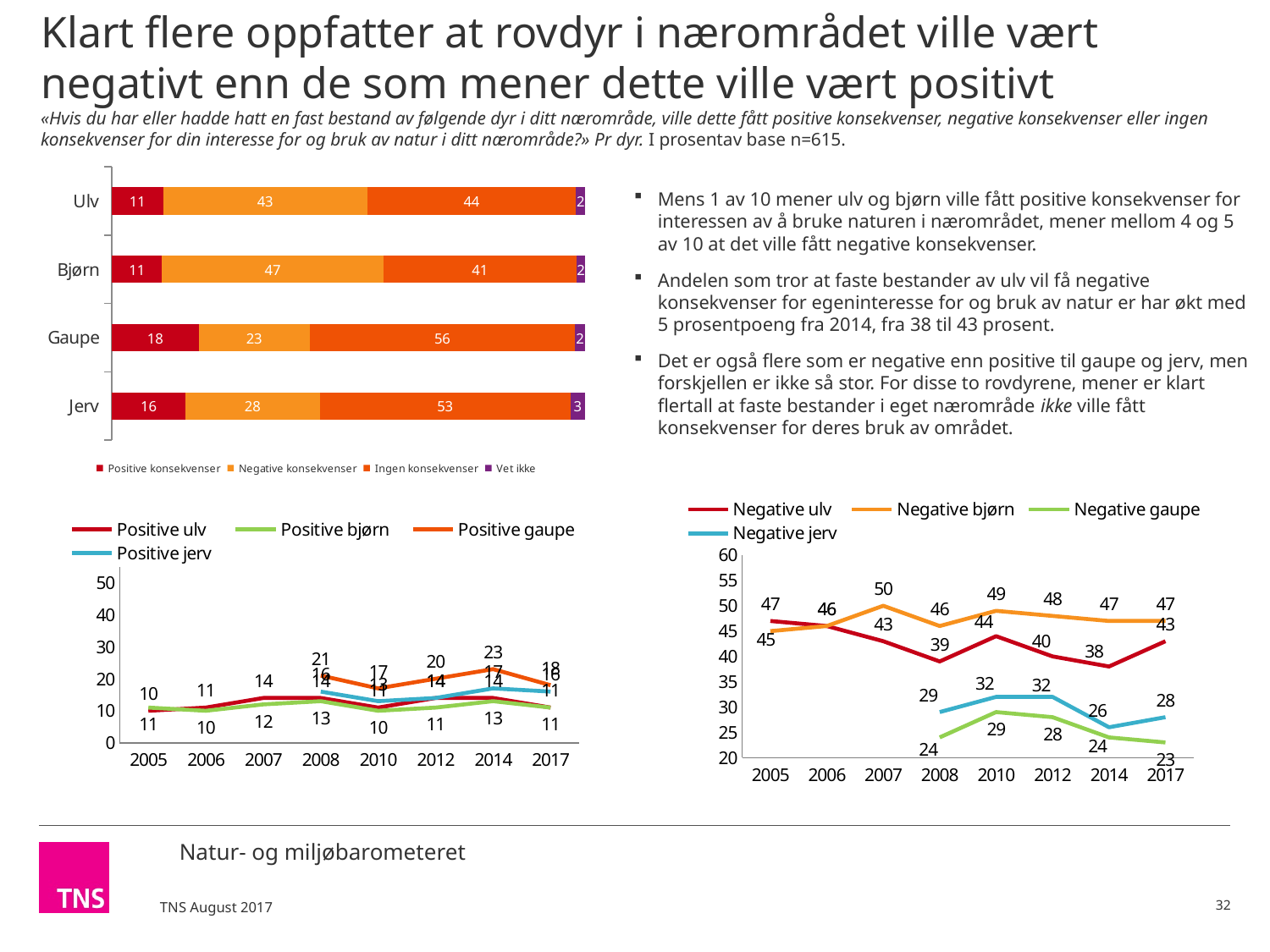
What type of chart is shown at the top left of the slide? Stacked bar chart In the stacked bar chart at the top left, what is the 'Vet ikke' value for Jerv? 3 In the stacked bar chart at the top left, how many series does the legend list? 4 In the line chart at the bottom right, what is the value for Negative ulv in 2014? 38 In the stacked bar chart at the top left, what is the 'Negative konsekvenser' value for Bjørn? 47 In the line chart at the bottom left, how many years are shown on the x axis? 8 In the stacked bar chart at the top left, what is the difference between the 'Negative konsekvenser' values for Bjørn and Gaupe? 24 In the stacked bar chart at the top left, what percentage of respondents said a permanent population of Gaupe would have 'Ingen konsekvenser'? 56 In the stacked bar chart at the top left, which animal has the highest 'Positive konsekvenser' value? Gaupe In the line chart at the bottom right, what is the value for Negative bjørn in 2007? 50 In the line chart at the bottom right, what is the difference between Negative jerv and Negative gaupe in 2017? 5 In the line chart at the bottom right, which is larger in 2017: Negative ulv or Negative bjørn? Negative bjørn